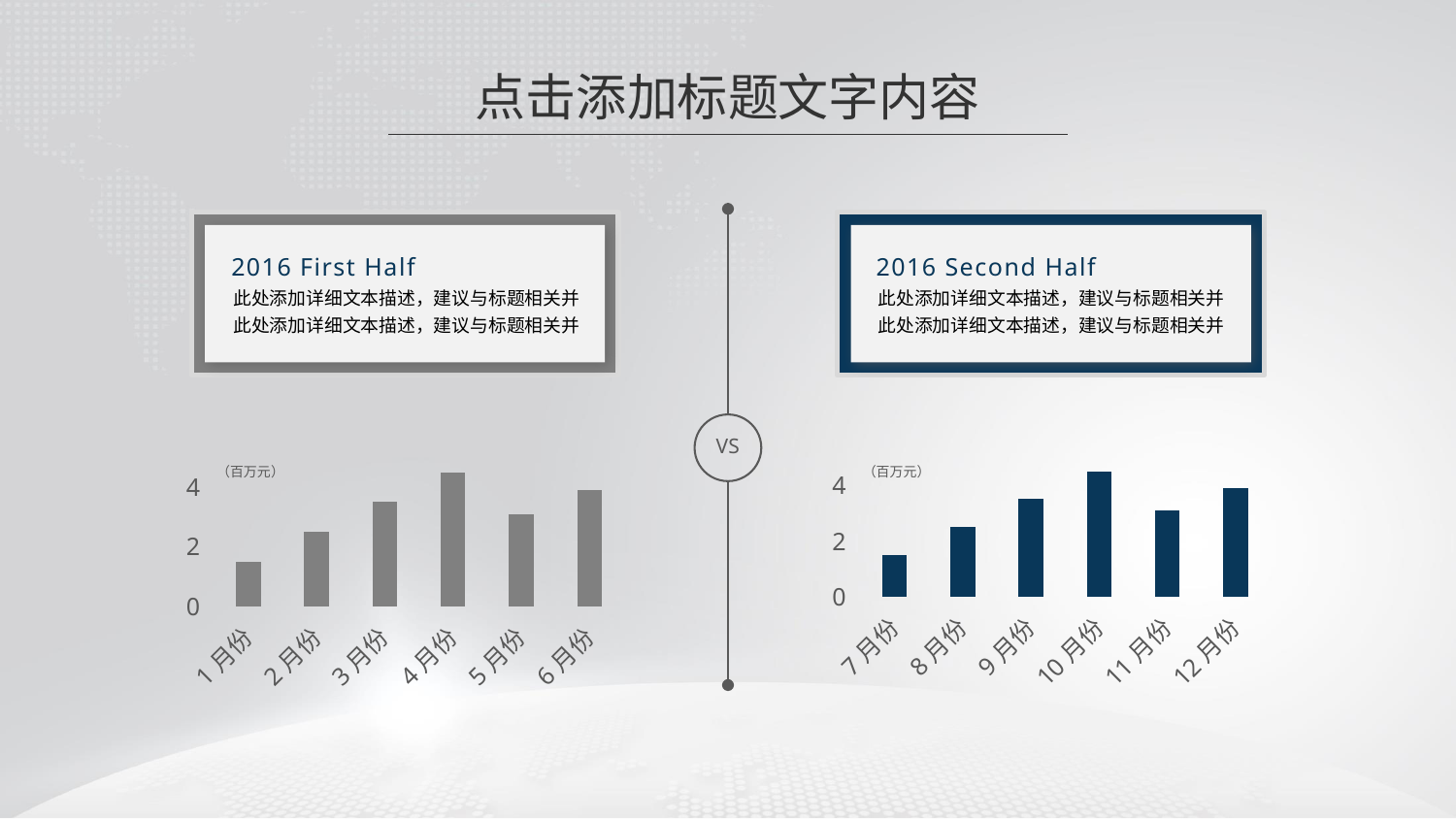
On the left chart (2016 First Half), is the value for 4月份 greater or less than 4? greater On the left chart (2016 First Half), which month has the lowest bar? 1月份 What kind of chart is the left chart (under 2016 First Half)? bar chart On the right chart (2016 Second Half), which month has the highest bar? 10月份 On the right chart (2016 Second Half), which month has the lowest bar? 7月份 On the left chart (2016 First Half), is the value for 1月份 greater or less than 2? less On the left chart (2016 First Half), which is larger, the bar for 2月份 or the bar for 6月份? 6月份 How many months are shown on the right chart (2016 Second Half)? 6 On the left chart (2016 First Half), which month has the highest bar? 4月份 On the right chart (2016 Second Half), is the value for 7月份 greater or less than 2? less How many months are shown on the left chart (2016 First Half)? 6 What unit is shown next to the y axis of the right chart (2016 Second Half)? 百万元